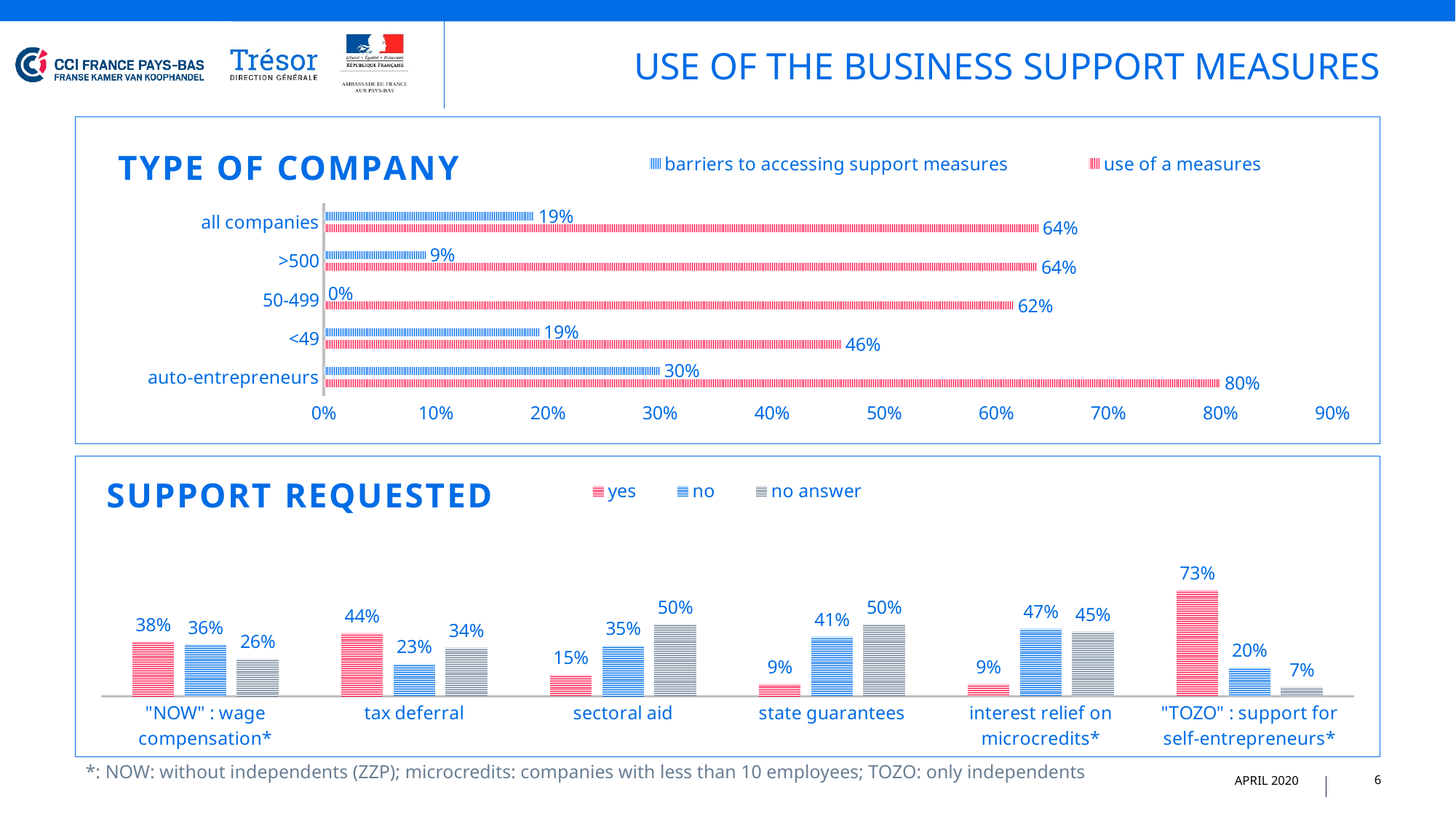
In the "Type of company" chart, which category has the highest "use of a measures" value? auto-entrepreneurs How many support measures are shown on the x axis of the "Support requested" chart? 6 How many series does the legend of the "Type of company" chart list? 2 In the "Type of company" chart, which category has the lowest "barriers to accessing support measures" value? 50-499 In the "Support requested" chart, is the "no answer" value larger for sectoral aid or for "TOZO" : support for self-entrepreneurs*? sectoral aid What kind of chart is the "Type of company" chart? bar chart In the "Support requested" chart, which support measure has the highest "yes" value? "TOZO" : support for self-entrepreneurs* In the "Type of company" chart, what is the difference between the "use of a measures" and "barriers to accessing support measures" values for <49? 27% In the "Type of company" chart, what is the "use of a measures" value for auto-entrepreneurs? 80% In the "Support requested" chart, what is the "yes" value for tax deferral? 44% In the "Support requested" chart, what is the difference between the "no" and "yes" values for state guarantees? 32% In the "Type of company" chart, what is the "barriers to accessing support measures" value for companies with >500 employees? 9%